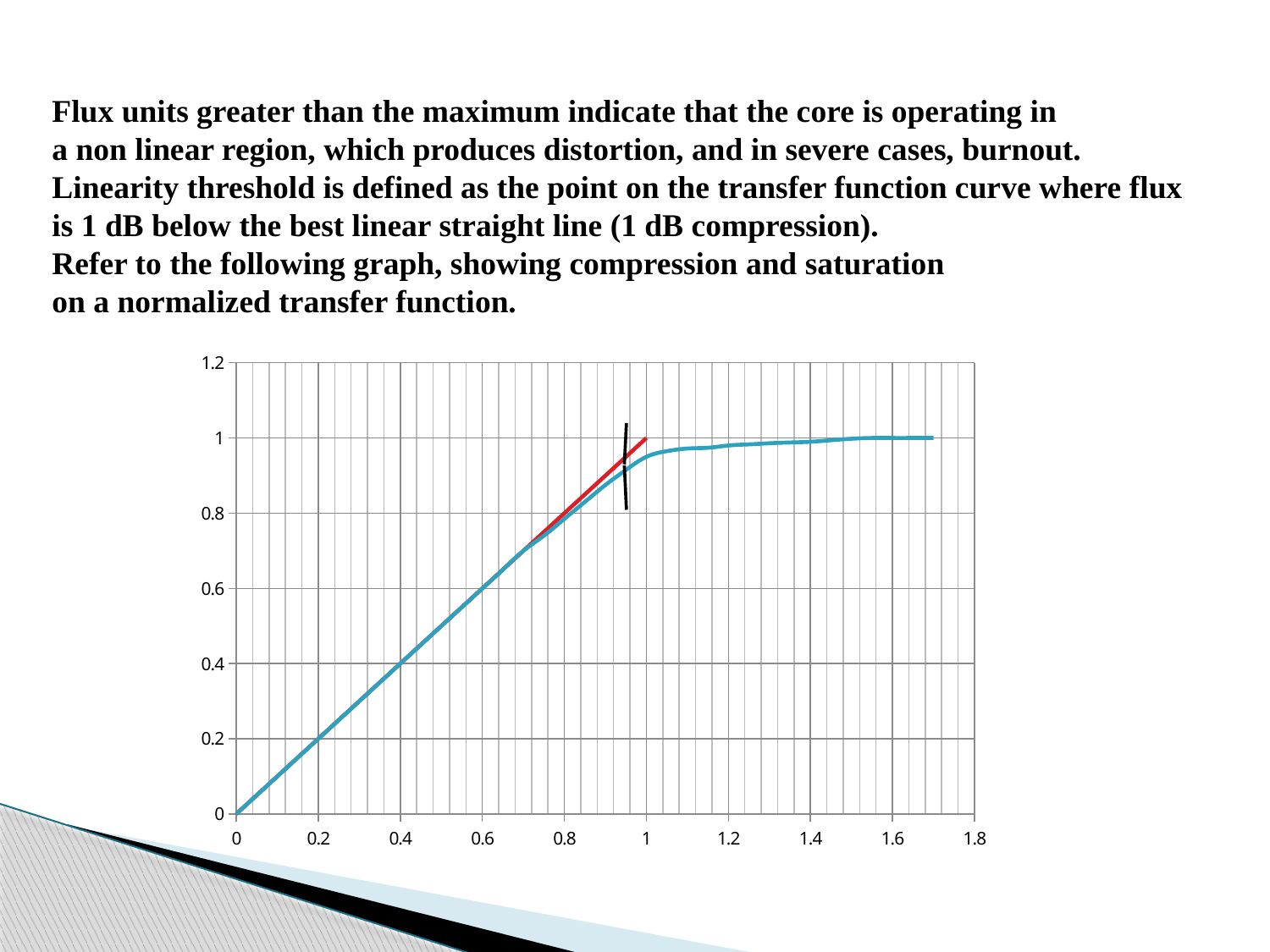
What colour is the straight line that extends above the curve near x = 1? red What is the highest value labelled on the y-axis of the chart? 1.2 What kind of chart is shown on the slide? line chart Is the value of the blue curve at x = 0.4 greater or less than 0.6? less Is the value of the blue curve at x = 1.6 greater or less than 1.2? less Is the value of the blue curve at x = 0.6 greater or less than 0.4? greater Which is larger: the value of the blue curve at x = 0.8 or at x = 0.2? at x = 0.8 Does the blue curve rise or fall as the x-axis value increases from 0 to 1? rises Which is larger: the value of the blue curve at x = 0.4 or at x = 1.4? at x = 1.4